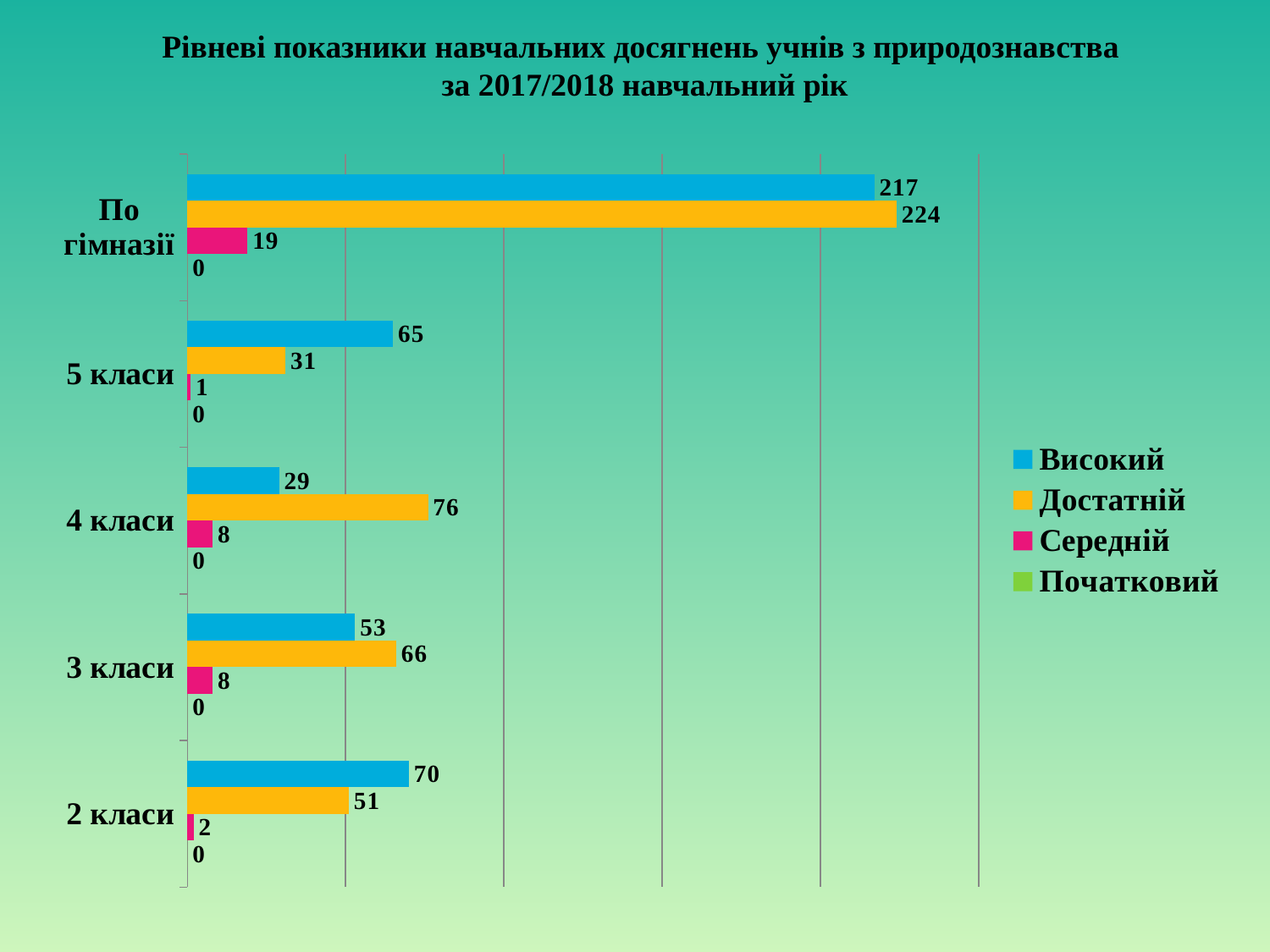
Which class group has the lowest Високий value? 4 класи What is the value of Високий for 5 класи? 65 What kind of chart is shown on the slide? Bar chart Which class group has the highest Достатній value (excluding По гімназії)? 4 класи Which is larger for 3 класи: Високий or Достатній? Достатній Which colour represents the Середній series in the legend? Pink What is the value of Початковий for 2 класи? 0 How many categories are shown on the vertical axis? 5 What is the difference between the Високий and Достатній values for 2 класи? 19 What is the value of Достатній for По гімназії? 224 What is the value of Середній for 4 класи? 8 How many series does the legend list? 4